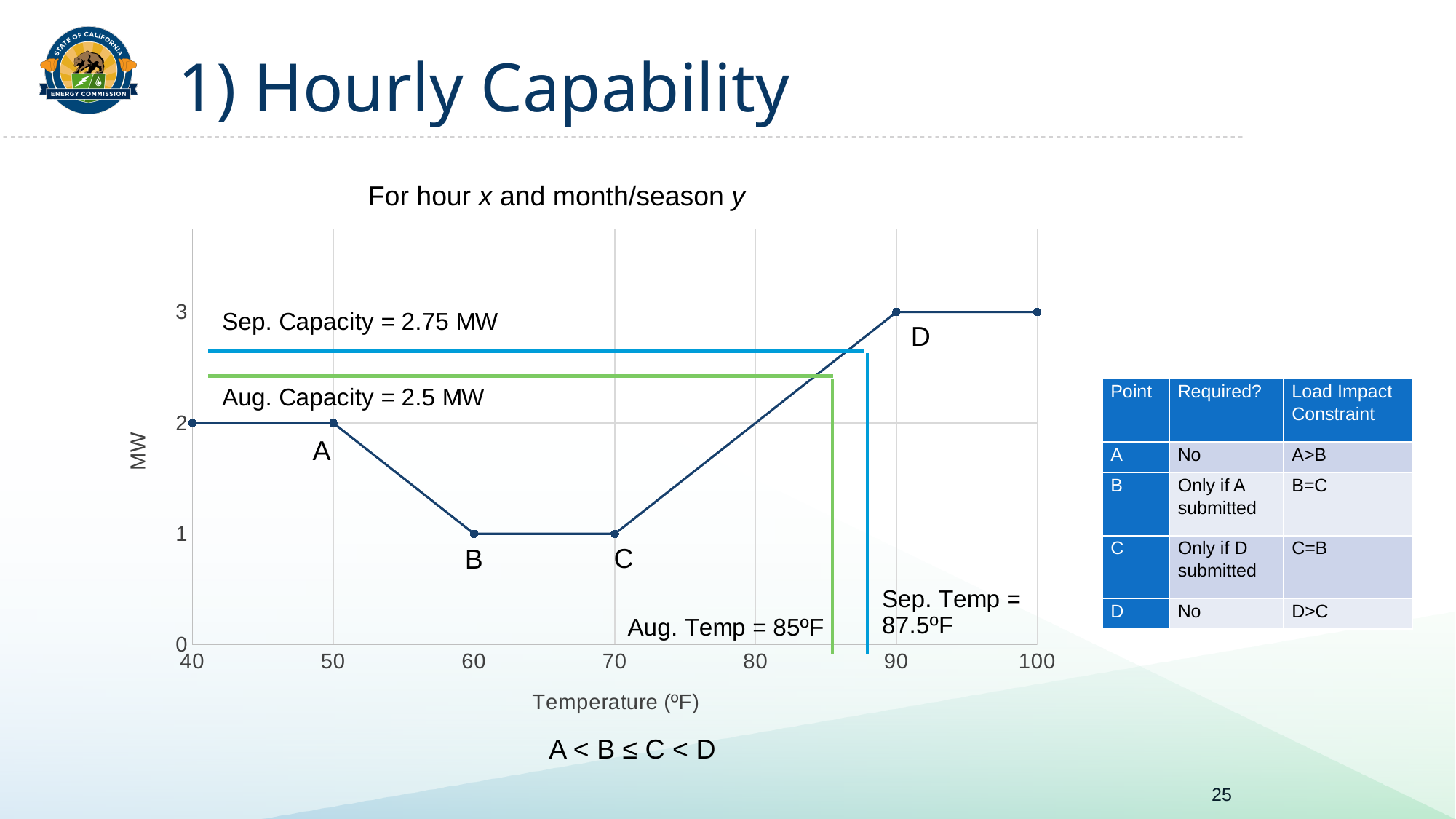
What is the Aug. Temp value annotated on the chart? 85ºF What is the x-axis title of the chart? Temperature (ºF) Which has the larger MW value, point A or point B? A Does the MW value rise or fall between point A (50 ºF) and point B (60 ºF)? fall What is the difference in MW between point D and point C? 2 What type of chart is shown on the slide? line chart What is the Aug. Capacity value annotated on the chart? 2.5 MW What is the MW value at point D (90 ºF)? 3 What is the MW value at point A (50 ºF)? 2 Which labelled point (A, B, C or D) has the highest MW value? D What is the MW value at point B (60 ºF)? 1 What is the Sep. Capacity value annotated on the chart? 2.75 MW